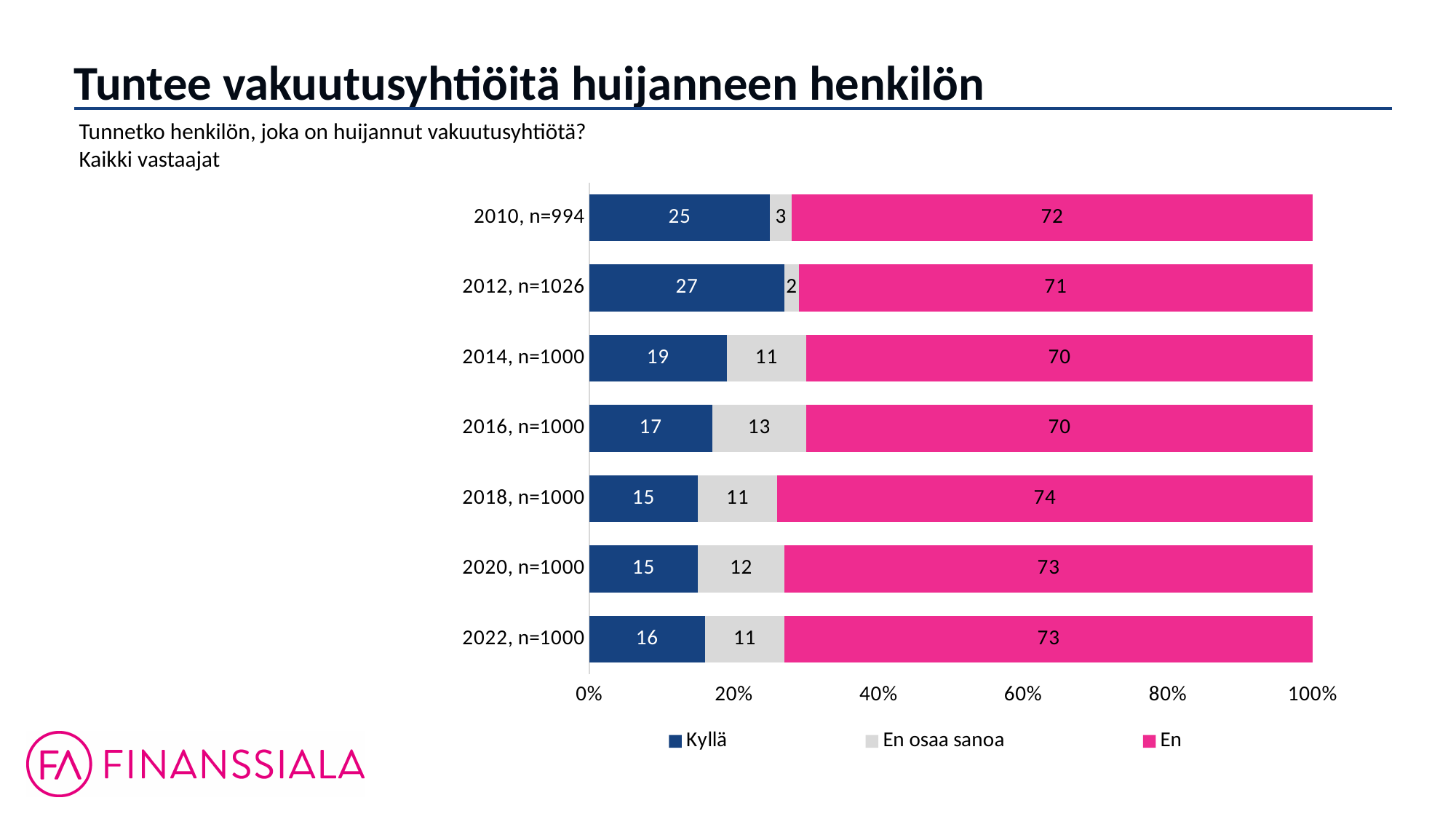
How many series does the legend list? 3 What is the value for En osaa sanoa in 2016, n=1000? 13 What kind of chart is shown on the slide? Stacked bar chart What is the value for En in 2018, n=1000? 74 What is the total of the stacked bar for 2014, n=1000? 100 Which year has the highest value for Kyllä? 2012, n=1026 Which is larger, the En value for 2014, n=1000 or for 2020, n=1000? 2020, n=1000 How many years (categories) are shown in the chart? 7 What is the value for Kyllä in 2010, n=994? 25 Does the Kyllä value generally rise or fall from 2010 to 2022? Fall What is the difference between the Kyllä values for 2010, n=994 and 2022, n=1000? 9 Which year has the lowest value for En osaa sanoa? 2012, n=1026